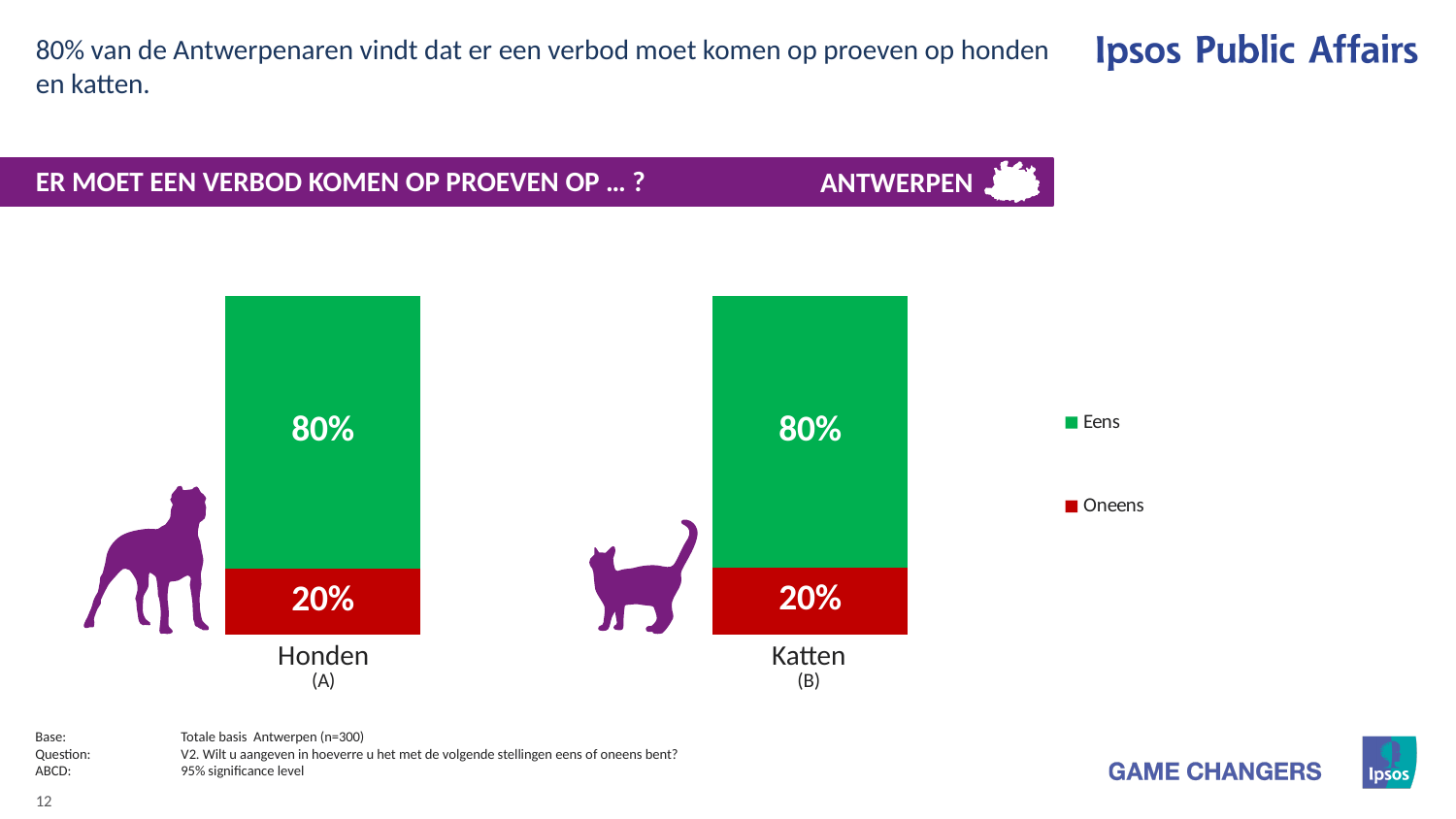
What is the difference between the 'Eens' and 'Oneens' shares for Honden? 60% What percentage of respondents answered 'Eens' for Katten? 80% What percentage of respondents answered 'Oneens' for Honden? 20% How many series does the legend list? 2 What kind of chart is shown on the slide? stacked bar chart Is the 'Eens' share for Honden larger or smaller than the 'Oneens' share for Honden? larger What are the two legend entries of the chart? Eens and Oneens How many categories are shown on the x axis of the chart? 2 What is the total of the stacked bar for Katten? 100% What percentage of respondents answered 'Oneens' for Katten? 20% Which colour represents 'Oneens' in the chart? red What percentage of respondents answered 'Eens' for Honden? 80%